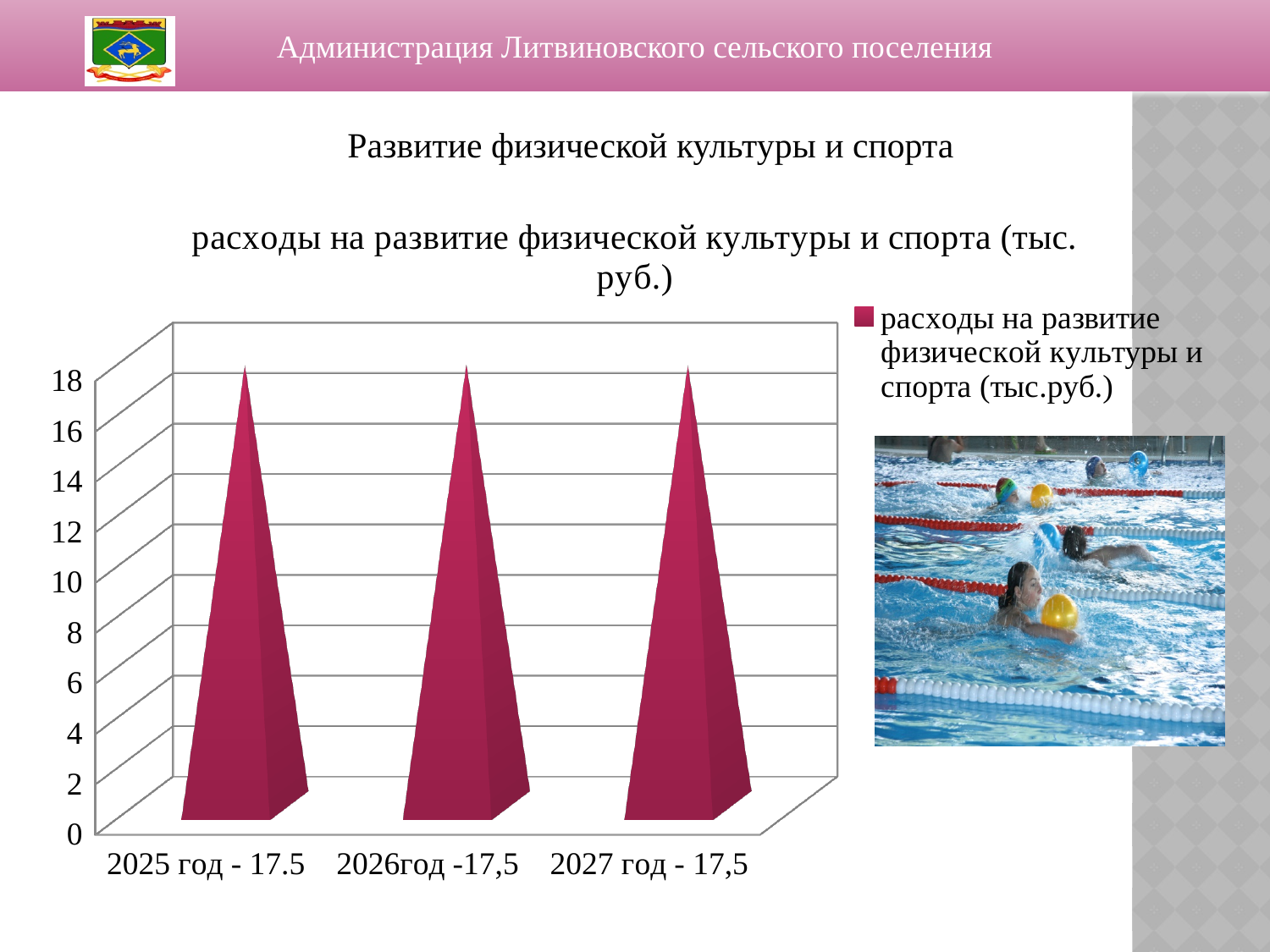
What value is given for 2025 год in the category label? 17.5 What is the legend entry of the chart? расходы на развитие физической культуры и спорта (тыс.руб.) Is the value for 2027 год greater or less than 10? greater How many categories (years) are plotted on the chart? 3 What is the title of the chart? расходы на развитие физической культуры и спорта (тыс. руб.) Do the values rise, fall or stay the same from 2025 to 2027? stay the same How many series does the chart legend list? 1 What value is given for 2027 год in the category label? 17,5 Is the value for 2025 год greater or less than 16? greater What kind of chart is shown on the slide? bar chart What is the highest tick value shown on the vertical axis? 18 What value is given for 2026 год in the category label? 17,5